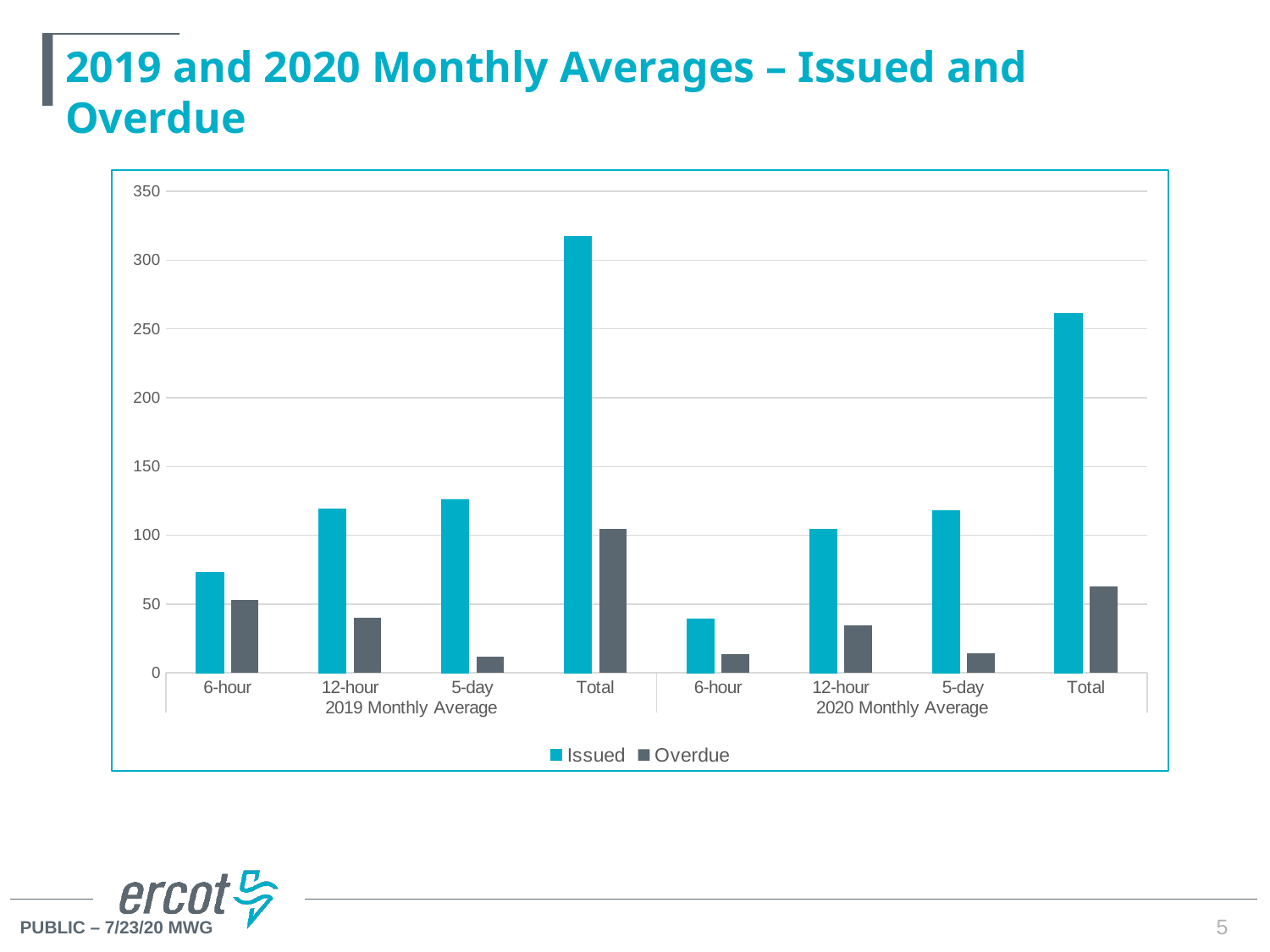
What are the two series named in the legend? Issued and Overdue Which is larger: the Issued value for Total in 2019 or the Issued value for Total in 2020? Total in 2019 Which category has the lowest Issued bar? 6-hour (2020 Monthly Average) Which category has the highest Issued bar? Total (2019 Monthly Average) Is the Issued value for 6-hour in the 2020 Monthly Average greater or less than 50? less Is the Issued value for Total in the 2020 Monthly Average greater or less than 300? less What kind of chart is shown on the slide? bar chart Which is larger: the Overdue value for 6-hour in 2019 or the Overdue value for 6-hour in 2020? 6-hour in 2019 How many categories are shown along the x axis in total across both years? 8 Is the Issued value for Total in the 2019 Monthly Average greater or less than 300? greater How many series does the legend list? 2